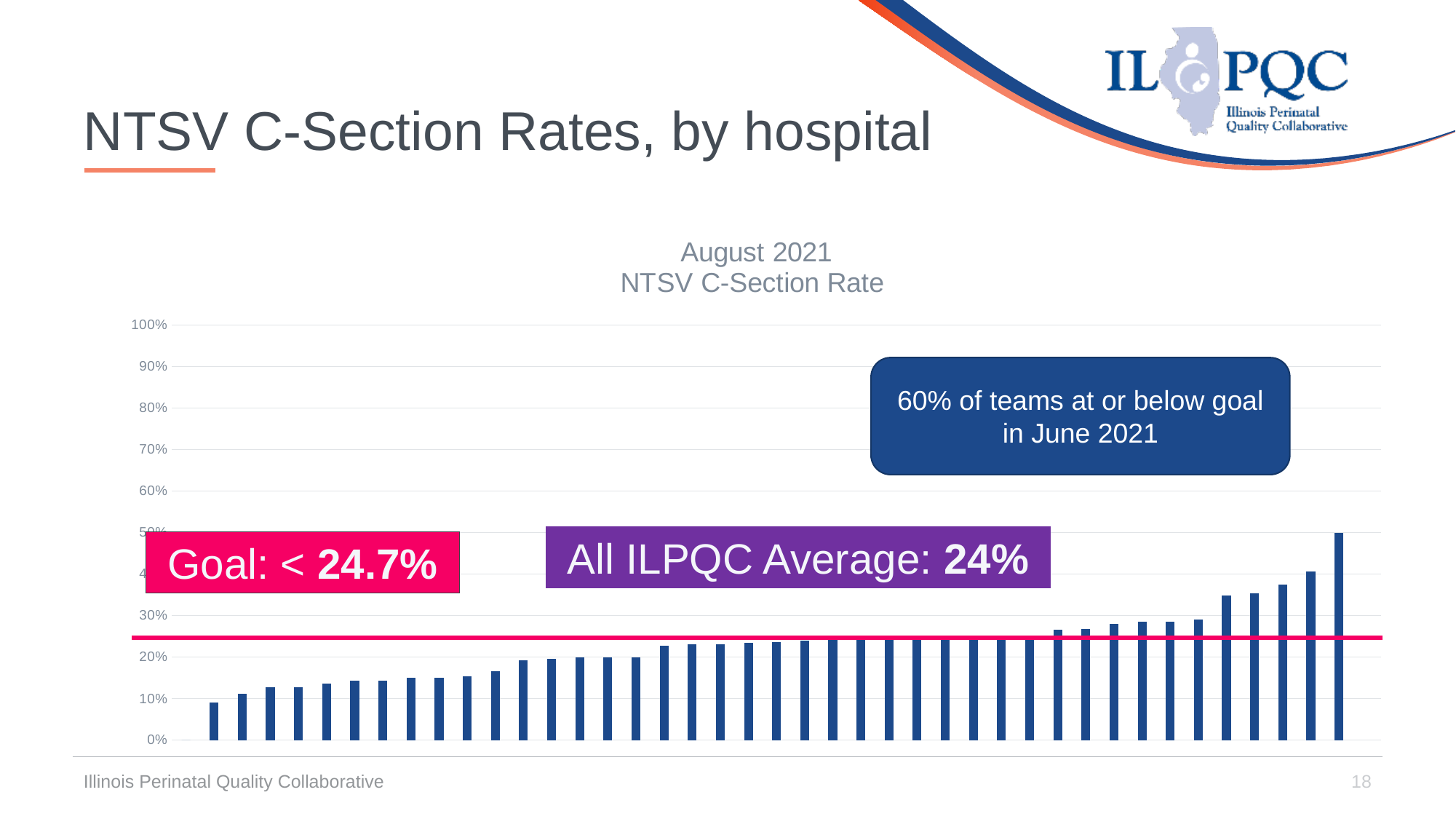
What is the highest value shown on the y axis? 100% What goal value is shown on the chart? < 24.7% What kind of chart is shown on the slide? bar chart What is the All ILPQC Average shown on the chart? 24% Which bar has the highest value, the leftmost or the rightmost? rightmost What is the title of the chart? August 2021 NTSV C-Section Rate Is the value of the tallest bar greater or less than 60%? less Where on the chart is the lowest bar located? far left Do the bar values rise or fall from left to right across the chart? rise Is the value of the rightmost bar greater or less than 40%? greater Where on the chart is the highest bar located? far right Is the value of the leftmost bar greater or less than 10%? less